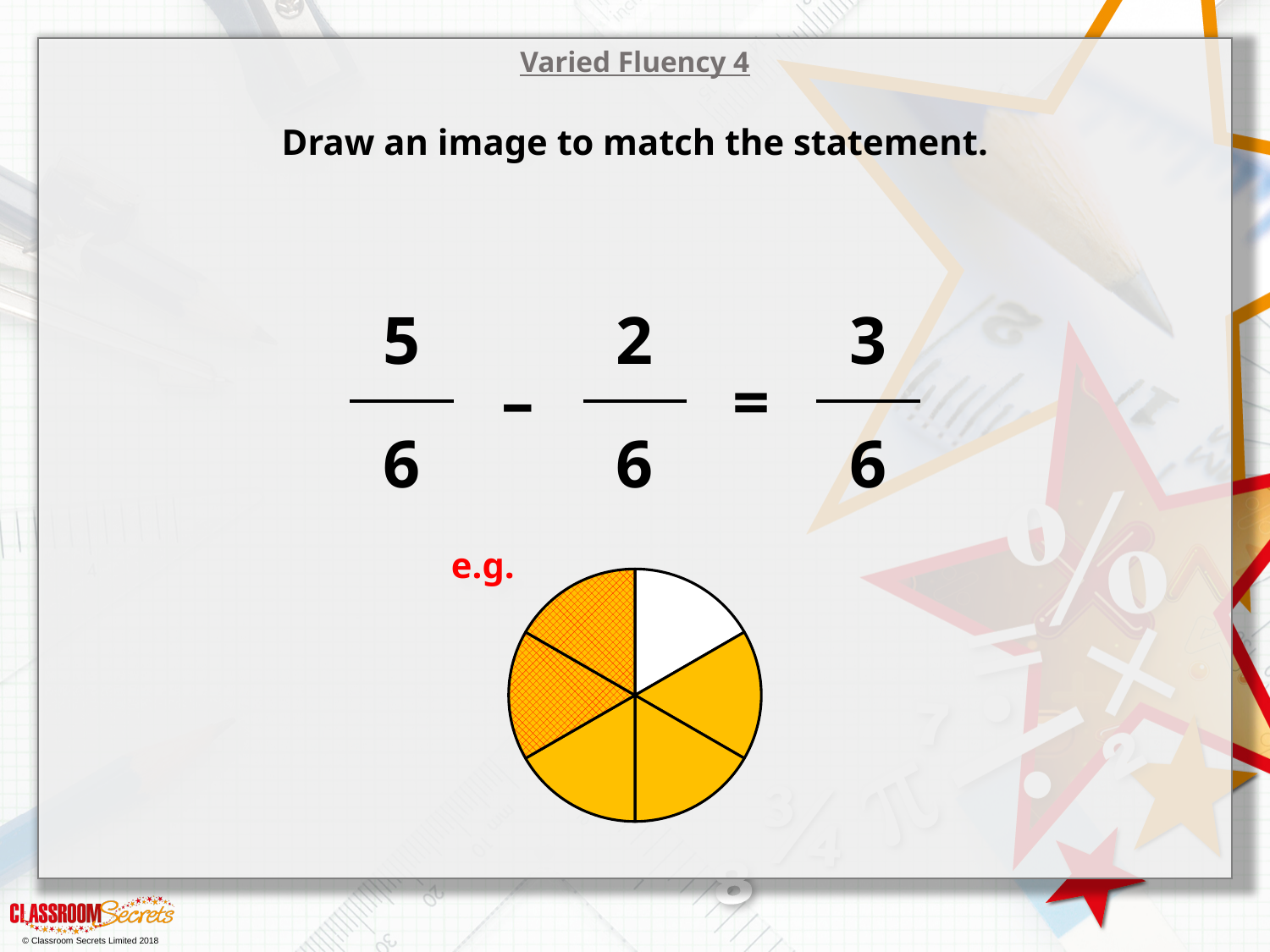
What colour are the shaded sections of the example circle? yellow How many sections of the circle are left white (unshaded) in the example image? 1 What fraction of the circle is cross-hatched in the example image? 2/6 What fraction statement does the example image illustrate? 5/6 − 2/6 = 3/6 What fraction of the circle is shaded in the example image? 5/6 What fraction of the circle is shaded plain yellow without cross-hatching in the example image? 3/6 How many equal sections is the circle in the example image divided into? 6 How many sections of the circle are shaded (coloured) in the example image? 5 Are there more plain yellow sections or cross-hatched sections in the example circle? plain yellow What is the difference between the number of shaded sections and the number of cross-hatched sections in the example circle? 3